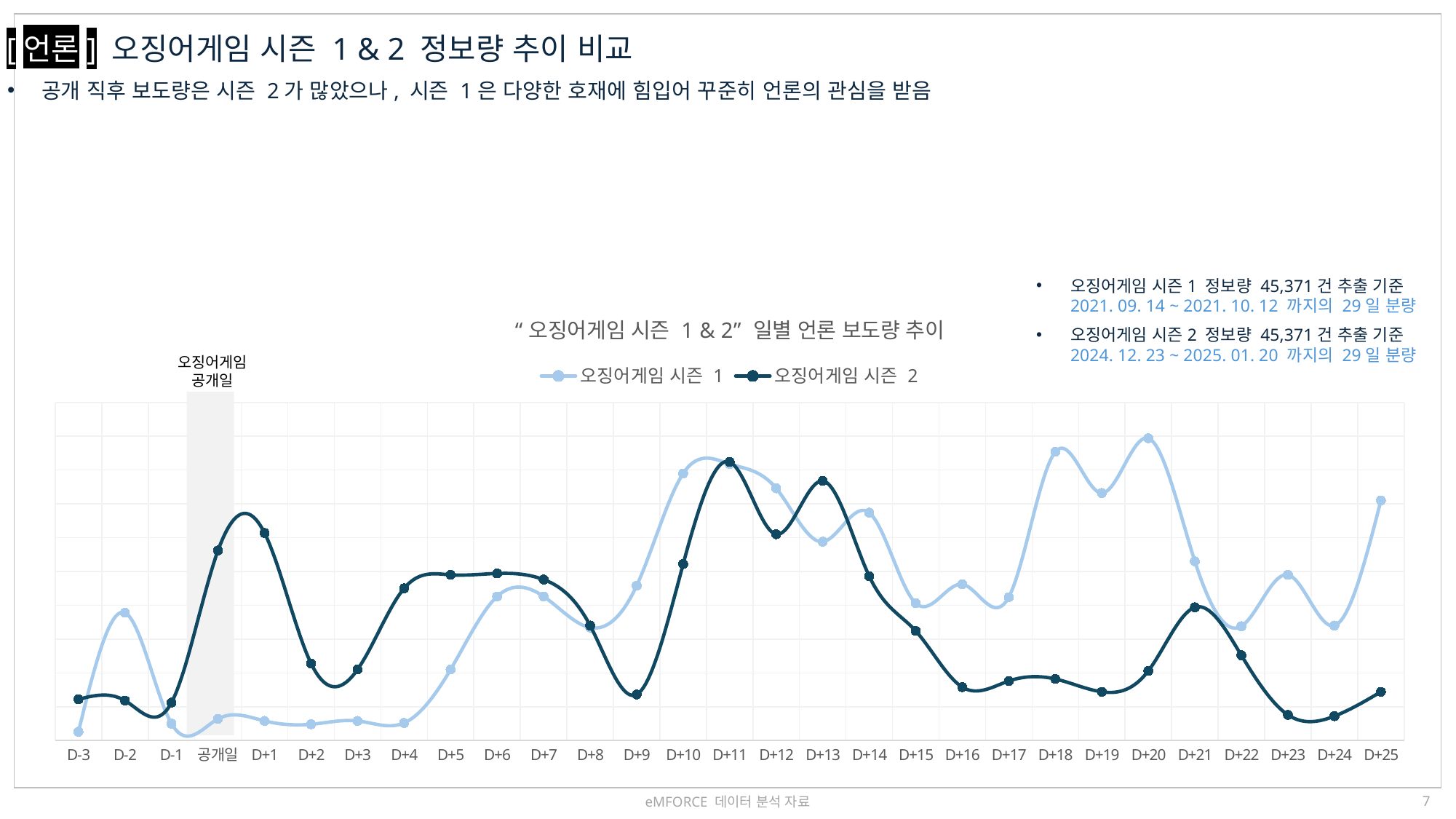
How many points are plotted along the x axis for each series? 29 How many series does the legend list? 2 Does the 오징어게임 시즌 1 series rise or fall from D+20 to D+22? fall What is the title of the chart? "오징어게임 시즌 1 & 2" 일별 언론 보도량 추이 On which day does the 오징어게임 시즌 1 series have its lowest value? D-3 Does the 오징어게임 시즌 2 series rise or fall from D-1 to D+1? rise On which day does the 오징어게임 시즌 1 series reach its highest value? D+20 What are the two series named in the legend? 오징어게임 시즌 1, 오징어게임 시즌 2 What kind of chart is shown on the slide? line chart On which day does the 오징어게임 시즌 2 series reach its highest value? D+11 At D+18, which series has the higher value, 오징어게임 시즌 1 or 오징어게임 시즌 2? 오징어게임 시즌 1 At D+1, which series has the higher value, 오징어게임 시즌 1 or 오징어게임 시즌 2? 오징어게임 시즌 2